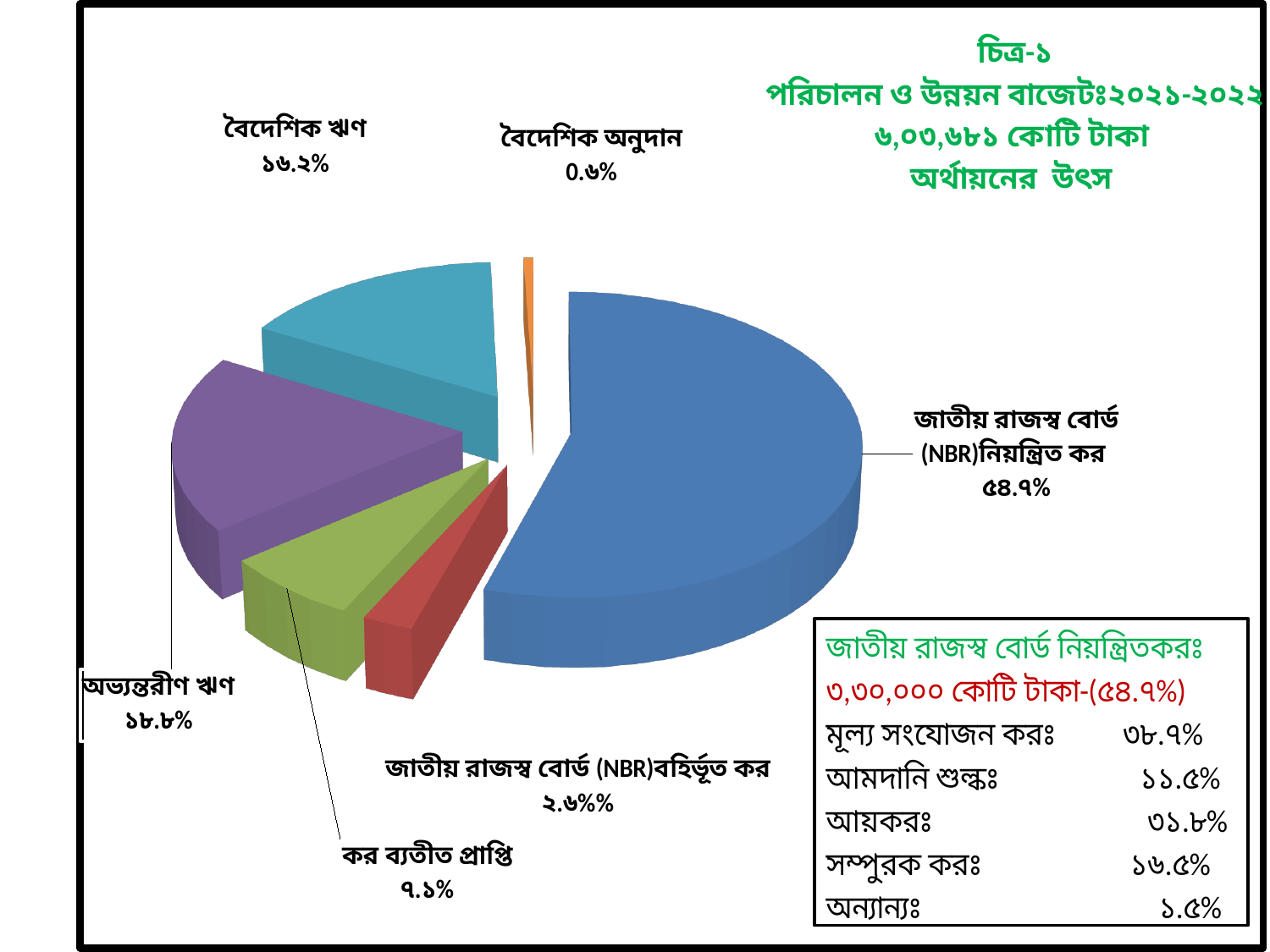
What share of the pie does কর ব্যতীত প্রাপ্তি represent? ৭.১% What percentage is shown for জাতীয় রাজস্ব বোর্ড (NBR) নিয়ন্ত্রিত কর? ৫৪.৭% What colour is the slice for জাতীয় রাজস্ব বোর্ড (NBR) নিয়ন্ত্রিত কর? Blue What is the difference in percentage points between অভ্যন্তরীণ ঋণ and বৈদেশিক ঋণ? ২.৬% What kind of chart is shown on the slide? Pie chart What percentage is shown for বৈদেশিক ঋণ? ১৬.২% Which category has the largest share of the pie? জাতীয় রাজস্ব বোর্ড (NBR) নিয়ন্ত্রিত কর What percentage is shown for অভ্যন্তরীণ ঋণ? ১৮.৮% What percentage is shown for বৈদেশিক অনুদান? ০.৬% Which is larger, the share for অভ্যন্তরীণ ঋণ or the share for বৈদেশিক ঋণ? অভ্যন্তরীণ ঋণ How many slices does the pie chart have? 6 Which category has the smallest share of the pie? বৈদেশিক অনুদান